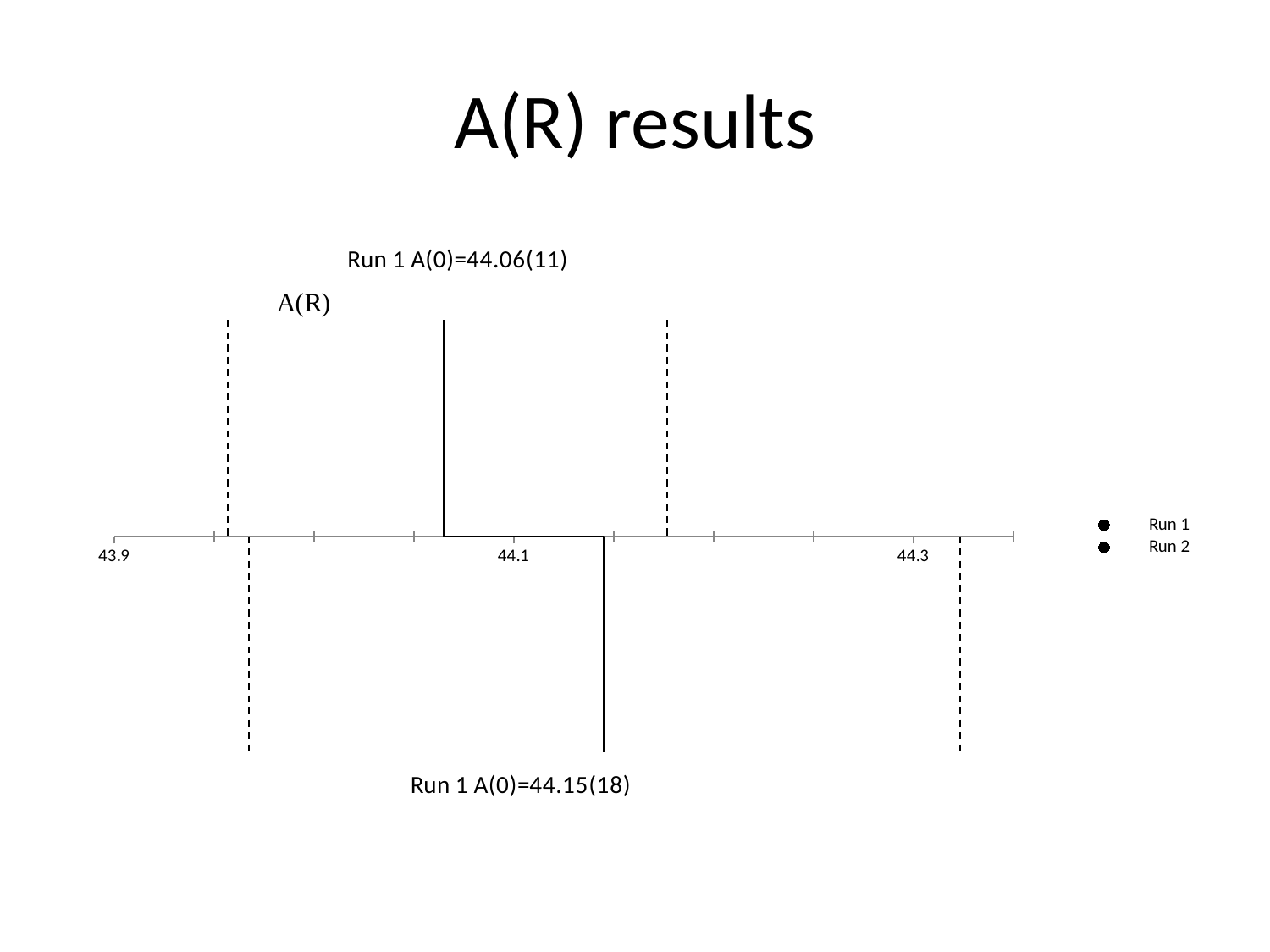
Is the value marked by the solid line above the axis greater or less than 44.1? less Is the value marked by the solid line below the axis greater or less than 44.1? greater What value of A(0) is printed in the label below the axis? 44.15(18) What is the label written near the top-left of the plot area? A(R) What is the leftmost tick label on the horizontal axis? 43.9 How many entries does the legend list? 2 What are the two entries in the legend? Run 1, Run 2 What is the title of the chart on the slide? A(R) results What value of A(0) is printed in the label above the axis? 44.06(11) What is the rightmost tick label on the horizontal axis? 44.3 Which printed A(0) value is larger, the one above the axis or the one below the axis? the one below the axis (44.15(18))